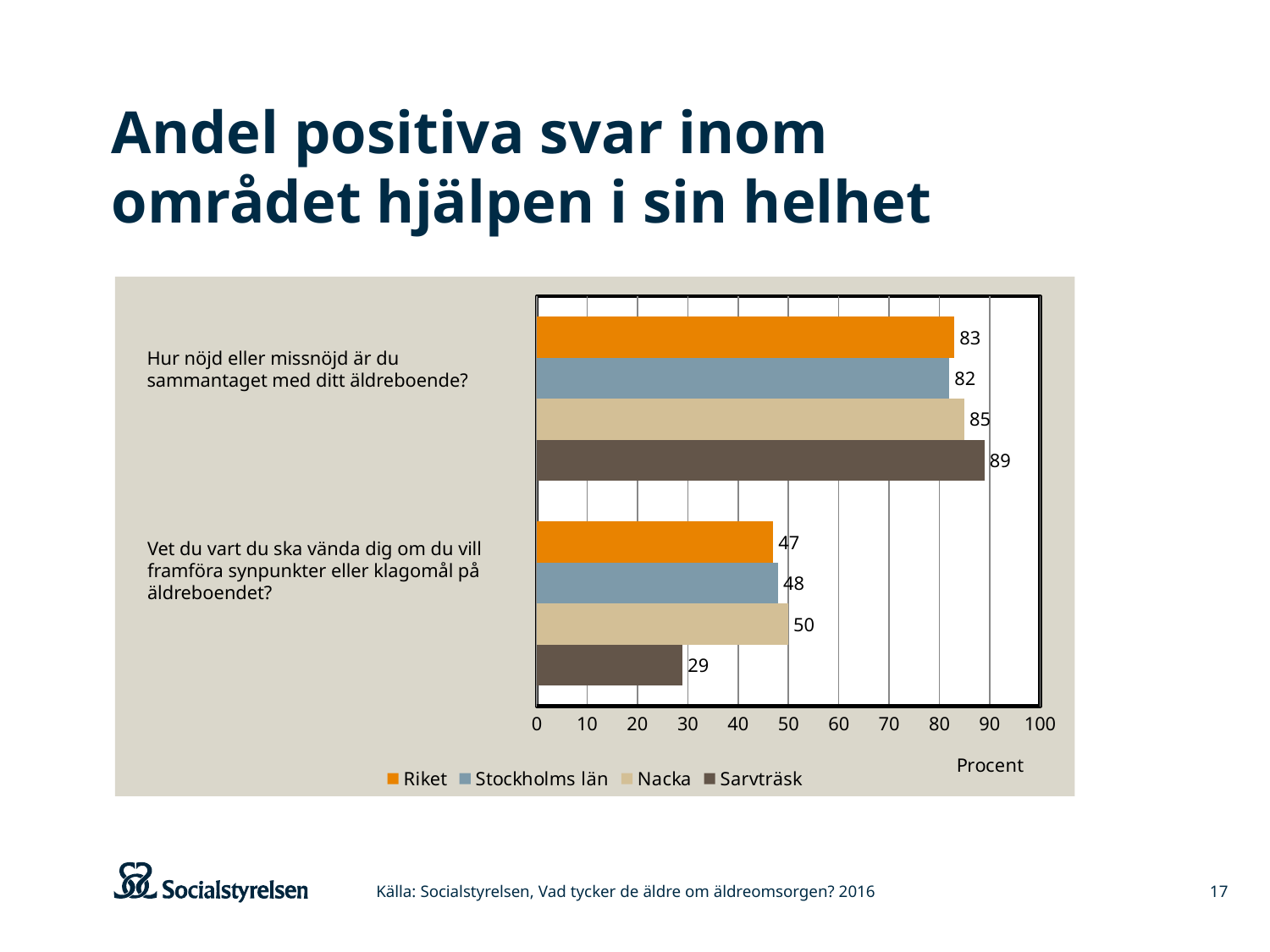
Which series has the highest value on the question "Hur nöjd eller missnöjd är du sammantaget med ditt äldreboende?"? Sarvträsk Which series has the lowest value on the question "Vet du vart du ska vända dig om du vill framföra synpunkter eller klagomål på äldreboendet?"? Sarvträsk What is the difference between the Sarvträsk value and the Riket value on the question "Hur nöjd eller missnöjd är du sammantaget med ditt äldreboende?"? 6 What kind of chart is shown on the slide? Bar chart What is the value for Riket on the question "Vet du vart du ska vända dig om du vill framföra synpunkter eller klagomål på äldreboendet?"? 47 What is the difference between the Nacka value and the Sarvträsk value on the question "Vet du vart du ska vända dig om du vill framföra synpunkter eller klagomål på äldreboendet?"? 21 What is the value for Sarvträsk on the question "Hur nöjd eller missnöjd är du sammantaget med ditt äldreboende?"? 89 How many series does the legend list? 4 What is the value for Nacka on the question "Hur nöjd eller missnöjd är du sammantaget med ditt äldreboende?"? 85 On the question "Vet du vart du ska vända dig om du vill framföra synpunkter eller klagomål på äldreboendet?", which is larger: the value for Nacka or the value for Riket? Nacka What is the value for Stockholms län on the question "Vet du vart du ska vända dig om du vill framföra synpunkter eller klagomål på äldreboendet?"? 48 What unit is shown on the horizontal axis of the chart? Procent